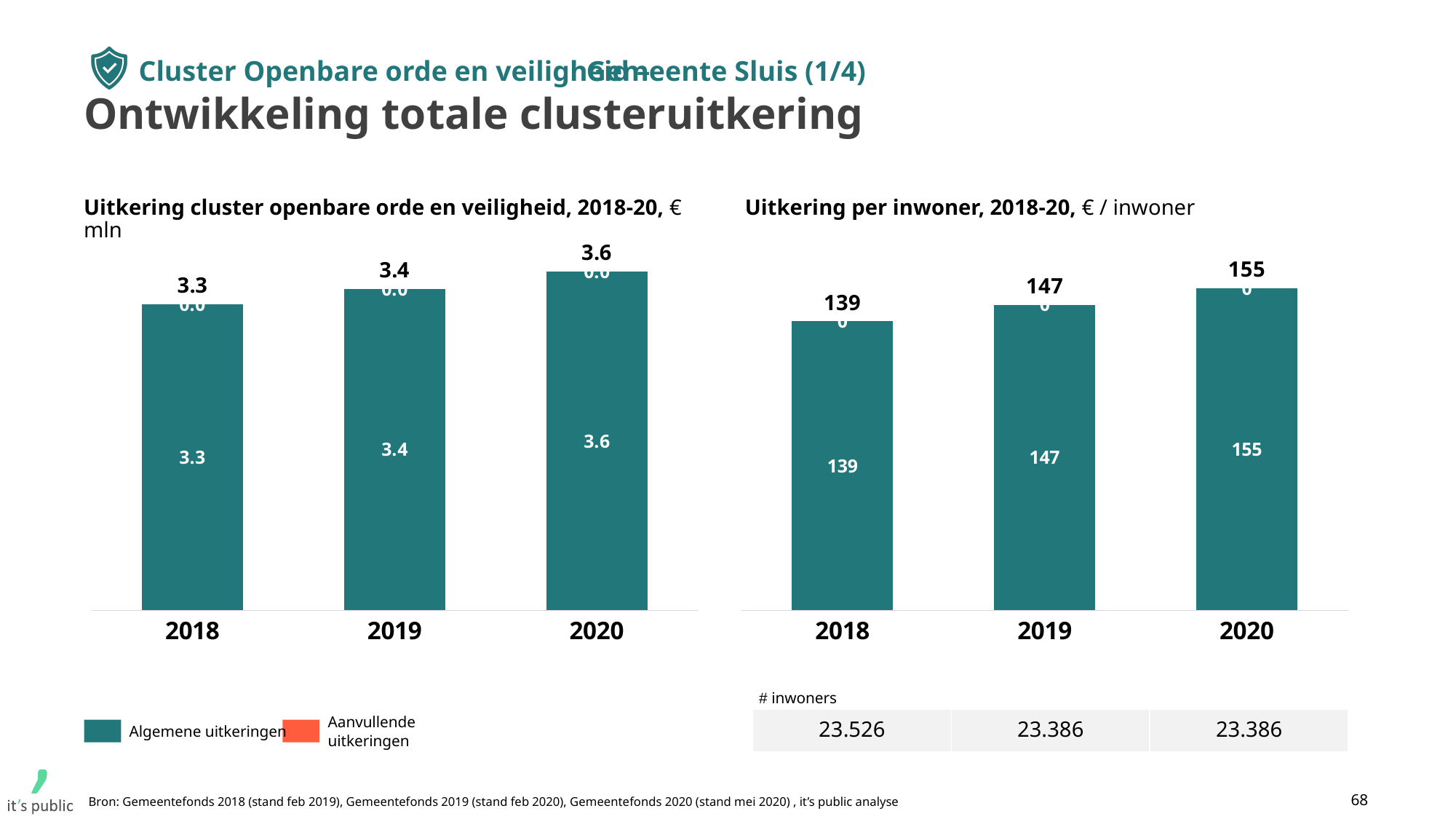
In the left chart, what is the name of the series shown in orange in the legend? Aanvullende uitkeringen In the left chart (Uitkering cluster openbare orde en veiligheid), what is the total value for 2018? 3.3 In the right chart (Uitkering per inwoner), which year has the lowest value? 2018 What kind of chart is the right chart (Uitkering per inwoner)? bar chart In the right chart (Uitkering per inwoner), what is the difference between the 2020 and 2018 values? 16 In the left chart (Uitkering cluster openbare orde en veiligheid), do the totals rise or fall from 2018 to 2020? rise How many years are shown on the x axis of the right chart (Uitkering per inwoner)? 3 How many series does the legend of the left chart list? 2 In the left chart (Uitkering cluster openbare orde en veiligheid), which year has the highest total? 2020 In the left chart (Uitkering cluster openbare orde en veiligheid), what is the difference between the 2020 and 2018 totals? 0.3 In the right chart (Uitkering per inwoner), what is the value for 2019? 147 In the left chart (Uitkering cluster openbare orde en veiligheid), what is the total value for 2020? 3.6